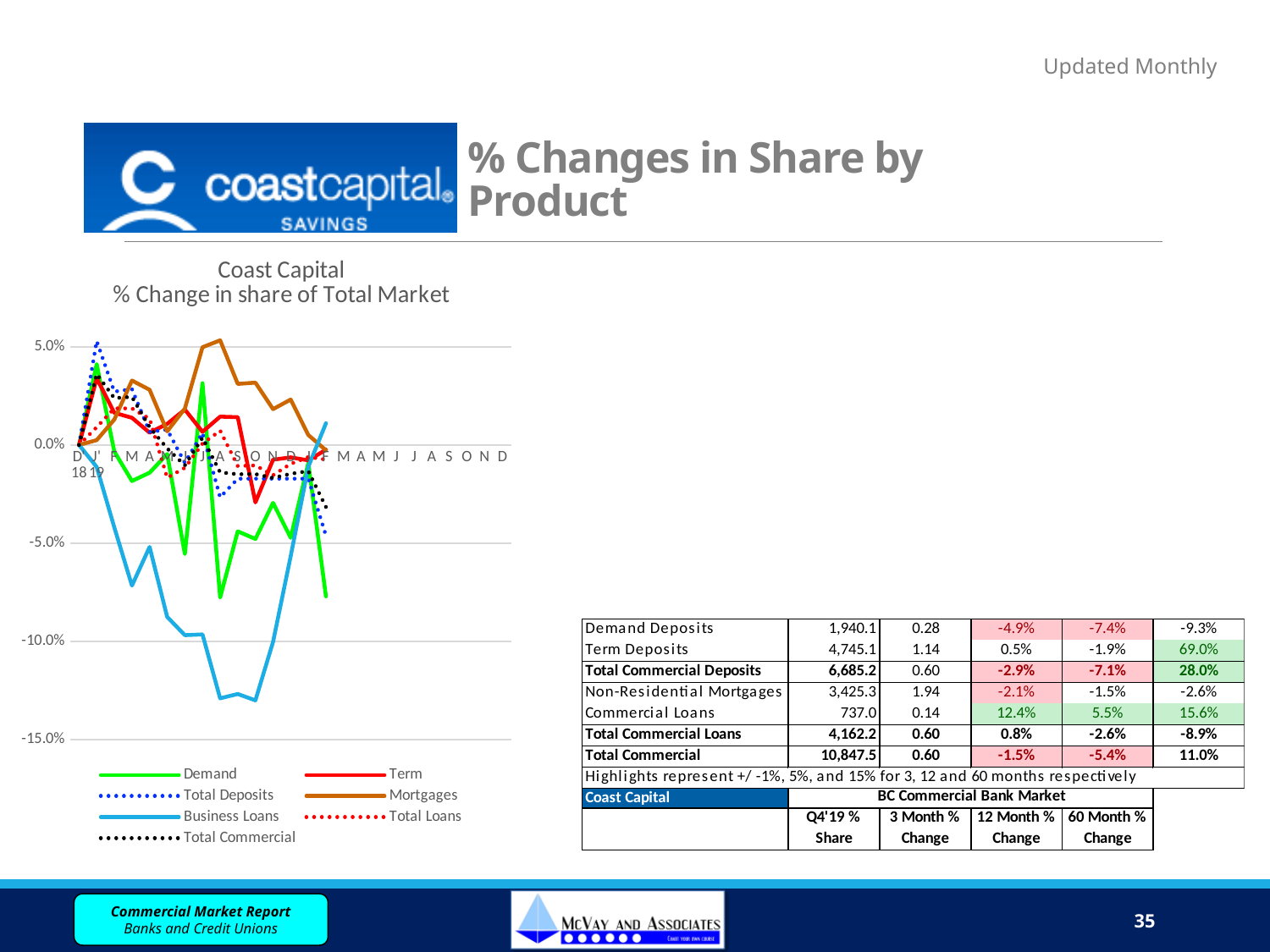
Which series in the chart is drawn in green? Demand What kind of chart is shown on the slide? line chart Is the highest value reached by the Mortgages series greater or less than 0.0%? greater Is the lowest value reached by the Business Loans series greater or less than -10.0%? less Which series dips lower in the chart, Business Loans or Demand? Business Loans Is the final plotted value of the Demand series greater or less than -5.0%? less Which series in the chart reaches the lowest value? Business Loans What is the title of the chart on the slide? Coast Capital % Change in share of Total Market How many series does the chart's legend list? 7